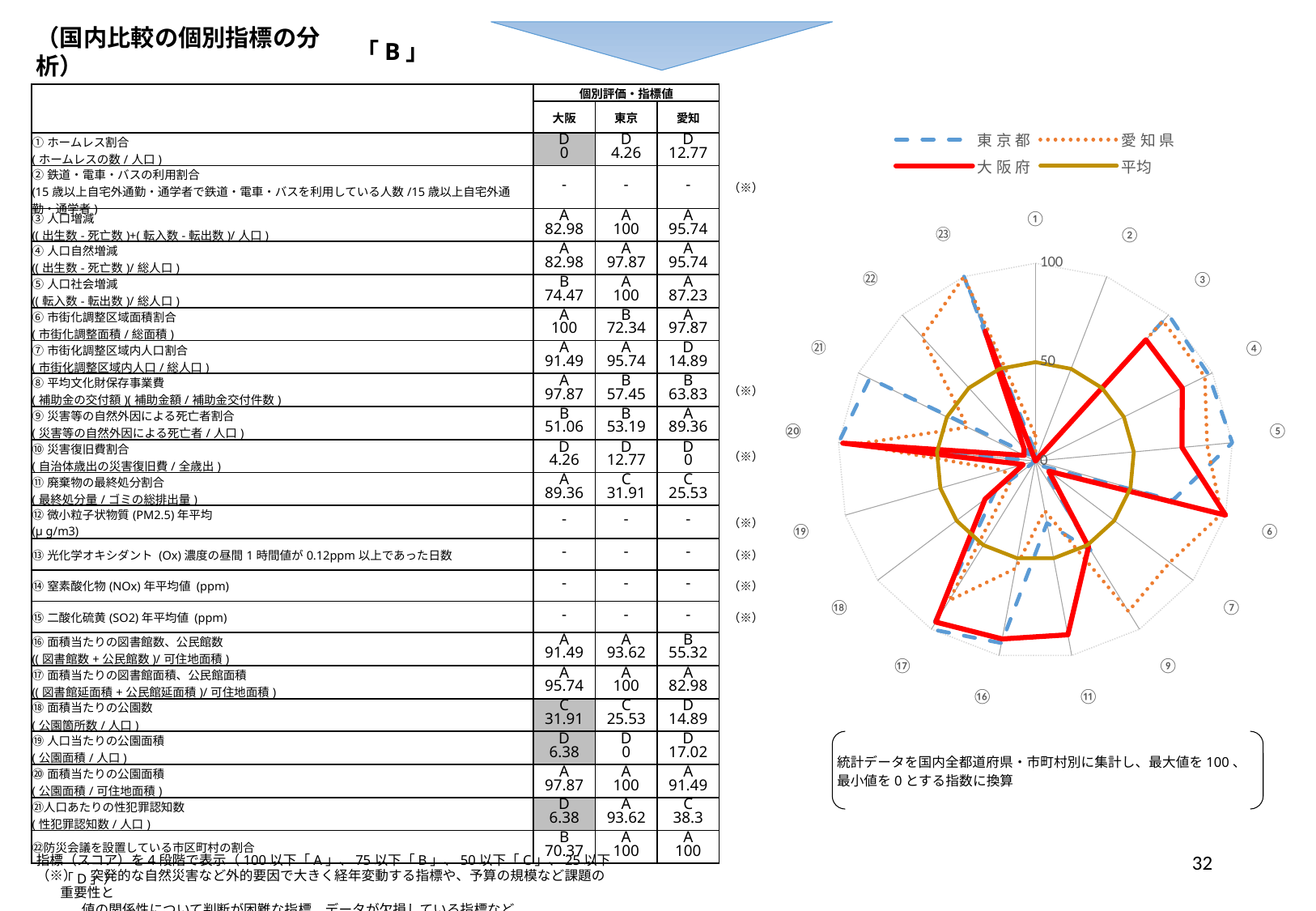
What kind of chart is shown on the right side of the slide? radar chart In the radar chart, is the value for 東京都 on axis ⑤ greater or less than 50? greater In the radar chart, is the value for 大阪府 on axis ⑲ greater or less than 50? less How many series does the legend of the radar chart list? 4 Which series in the radar chart is drawn with a dotted orange line? 愛知県 In the radar chart, is the value for 大阪府 on axis ⑥ greater or less than 50? greater What is the highest value shown on the radial axis of the radar chart? 100 Which series in the radar chart is drawn with a solid red line? 大阪府 In the radar chart, which is larger on axis ⑳: the value for 大阪府 or the value for 愛知県? 大阪府